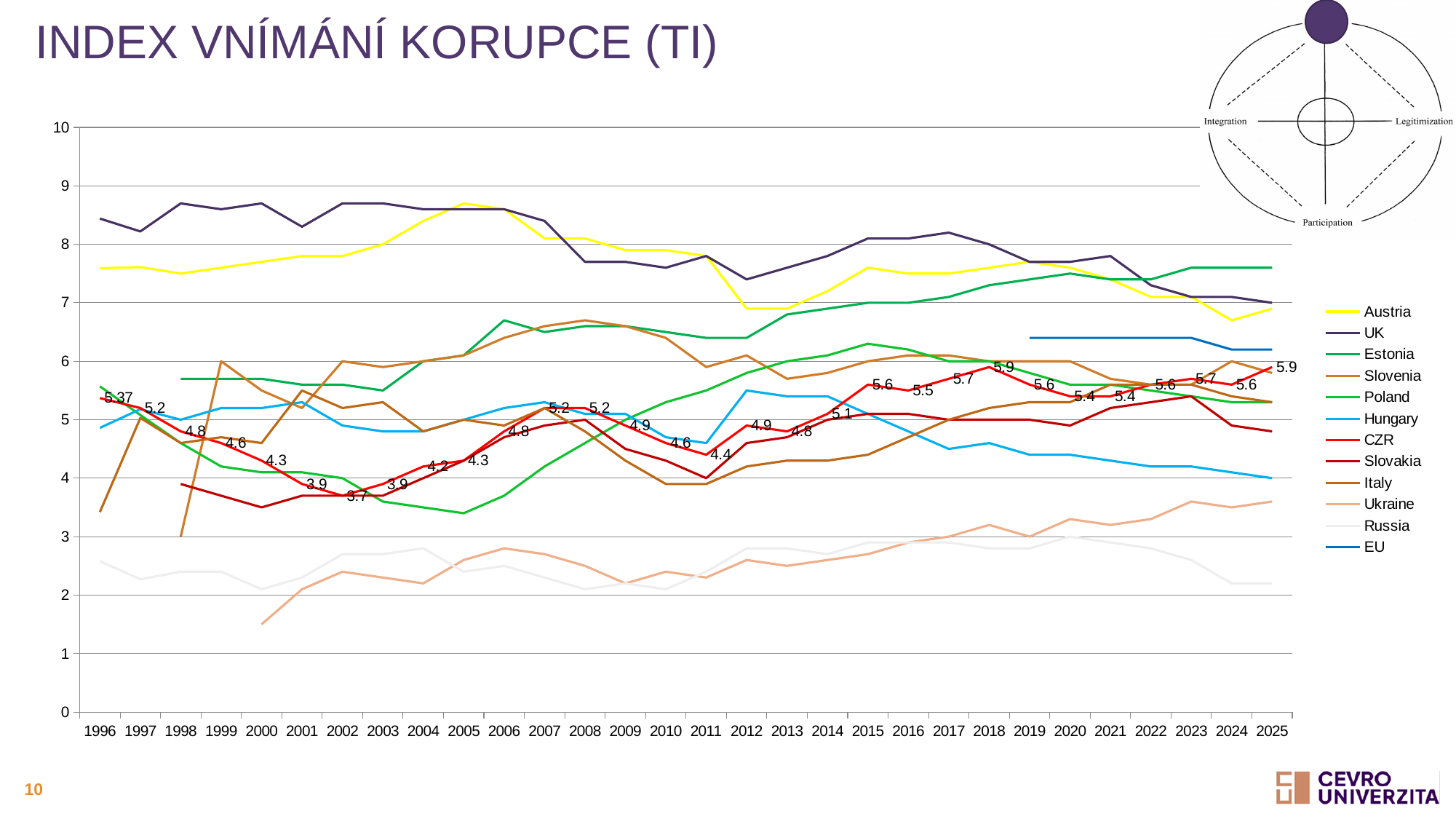
How many years are shown on the x axis? 30 What kind of chart is shown on the slide? line chart Is the value for UK in 1996 greater or less than 8? greater Which is larger for CZR: the value in 2007 or the value in 2011? 2007 What is the difference between the CZR value in 2025 and in 2002? 2.2 Is the value for Ukraine in 2000 greater or less than 2? less Does the CZR series rise or fall from 2000 to 2002? fall What is the value for CZR in 2011? 4.4 In which year does the CZR series reach its lowest value? 2002 What is the value for CZR in 1996? 5.37 How many series does the legend list? 12 What is the value for CZR in 2025? 5.9